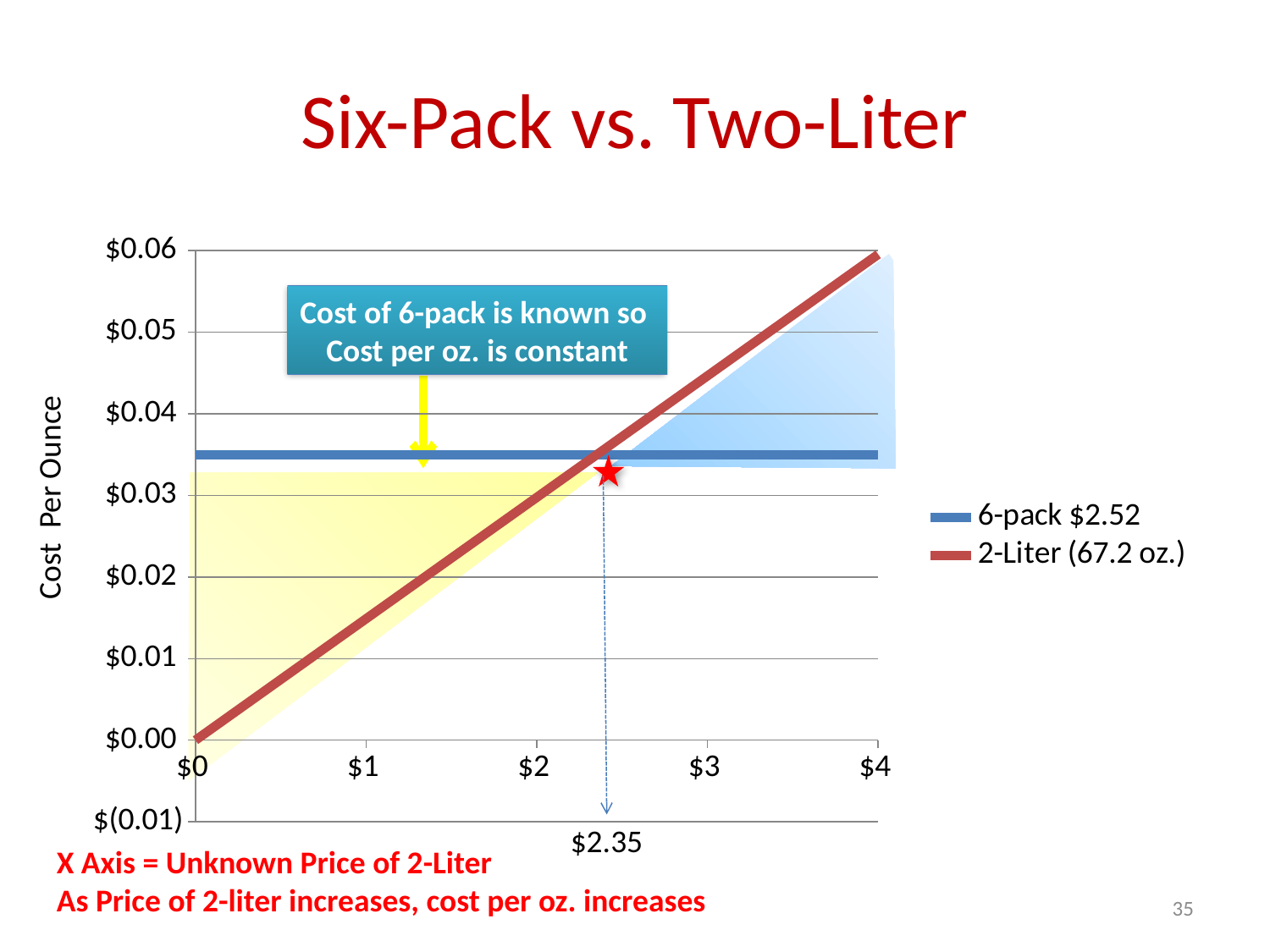
What is the label of the vertical axis? Cost Per Ounce What are the two series named in the legend? 6-pack $2.52 and 2-Liter (67.2 oz.) What kind of chart is shown on the slide? line chart Is the cost per ounce for the 2-Liter at a price of $3 greater or less than $0.04? greater Does the cost per ounce for the 2-Liter rise or fall as the price on the x axis increases? rises Is the cost per ounce for the 6-pack greater or less than $0.03? greater Is the cost per ounce for the 6-pack greater or less than $0.04? less How many series does the legend list? 2 At a 2-Liter price of $4, which series has the higher cost per ounce, the 6-pack or the 2-Liter? 2-Liter At what 2-Liter price, marked with a star, do the two lines cross? $2.35 At a 2-Liter price of $1, which series has the higher cost per ounce, the 6-pack or the 2-Liter? 6-pack